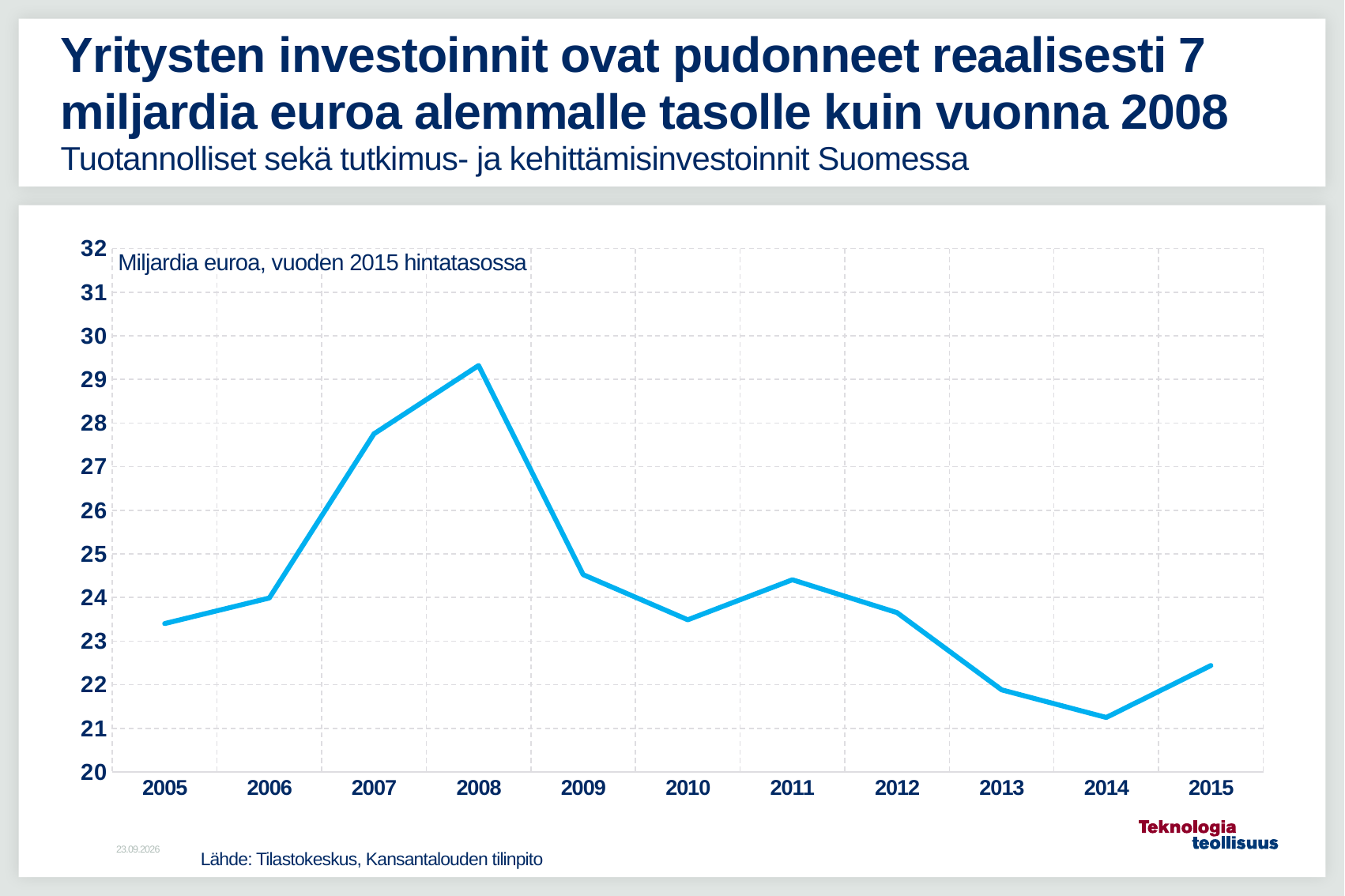
What kind of chart is shown on the slide? line chart Which year has the highest value on the chart? 2008 Which year has the larger value, 2011 or 2013? 2011 Is the value for 2009 greater or less than 24? greater Is the value for 2007 greater or less than 27? greater Is the value for 2005 greater or less than 24? less Which year has the lowest value on the chart? 2014 How many years are plotted on the x axis? 11 Which year has the larger value, 2007 or 2009? 2007 Do the values rise or fall from 2008 to 2014? fall